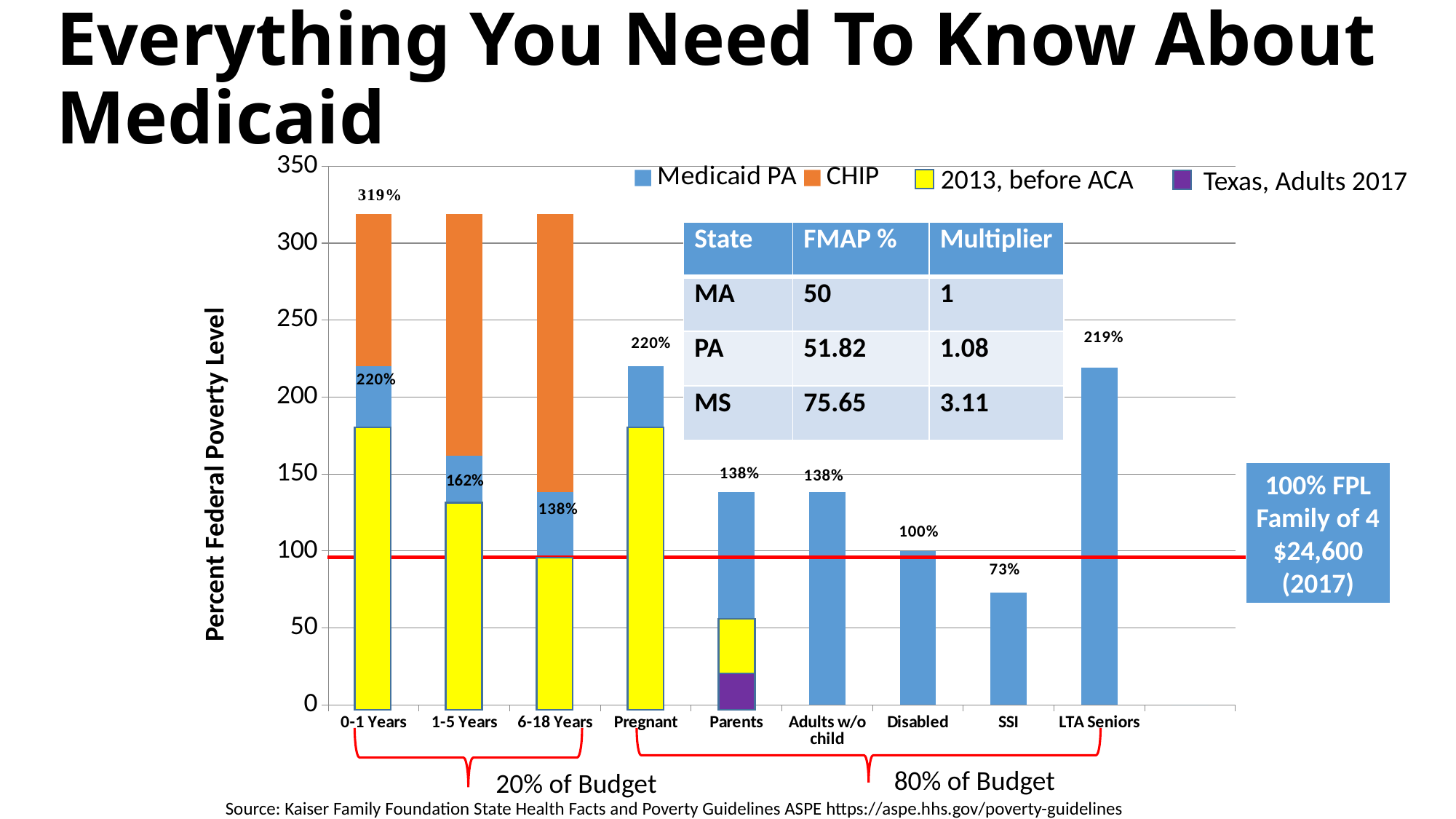
What kind of chart is shown on the slide? bar chart What is the labeled value for SSI? 73% What is the difference between the Pregnant value (220%) and the Disabled value (100%)? 120% Which category has the lowest labeled value? SSI What is the labeled value for the 1-5 Years bar? 162% How many categories are shown on the x axis? 9 Which is larger, the value for Disabled or the value for SSI? Disabled What is the labeled value for LTA Seniors? 219% What is the labeled value for Disabled? 100% What is the value printed at the top of the 0-1 Years bar? 319% How many series does the legend list? 4 Is the value for Adults w/o child greater or less than 100? greater